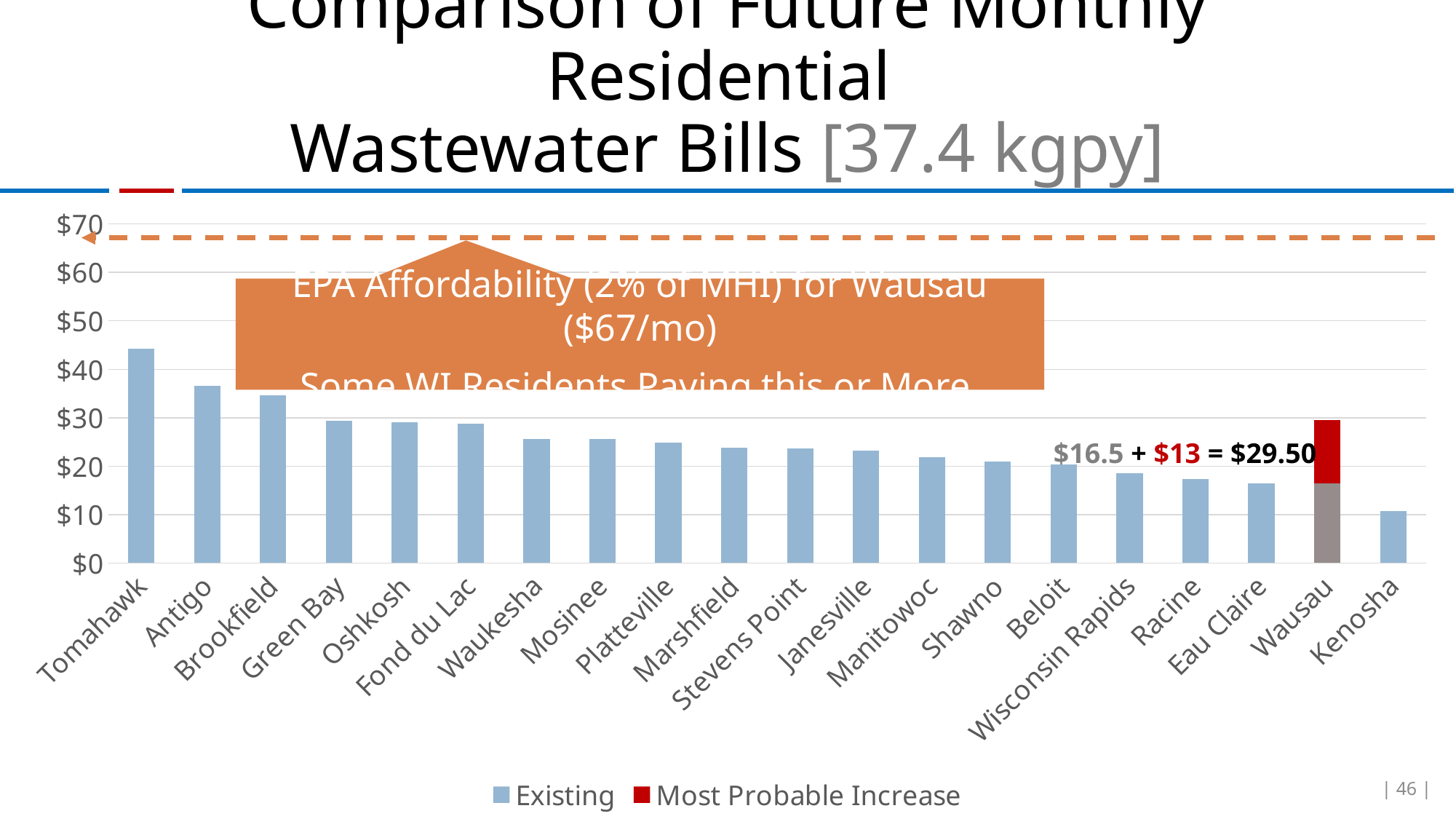
Which city has the lowest bar in the chart? Kenosha What is the total future monthly bill for Wausau shown on the chart? $29.50 How many cities are shown on the x axis of the chart? 20 Is the value for Kenosha greater or less than $20? less What kind of chart is shown on the slide? bar chart What is the Most Probable Increase for Wausau, as labelled on the chart? $13 How many series does the chart legend list? 2 Which has a larger bar, Tomahawk or Antigo? Tomahawk Which city has the highest bar in the chart? Tomahawk What monthly amount does the chart annotation give for EPA Affordability (2% of MHI) for Wausau? $67/mo What is the Existing monthly bill for Wausau, as labelled on the chart? $16.5 Is the value for Tomahawk greater or less than $40? greater